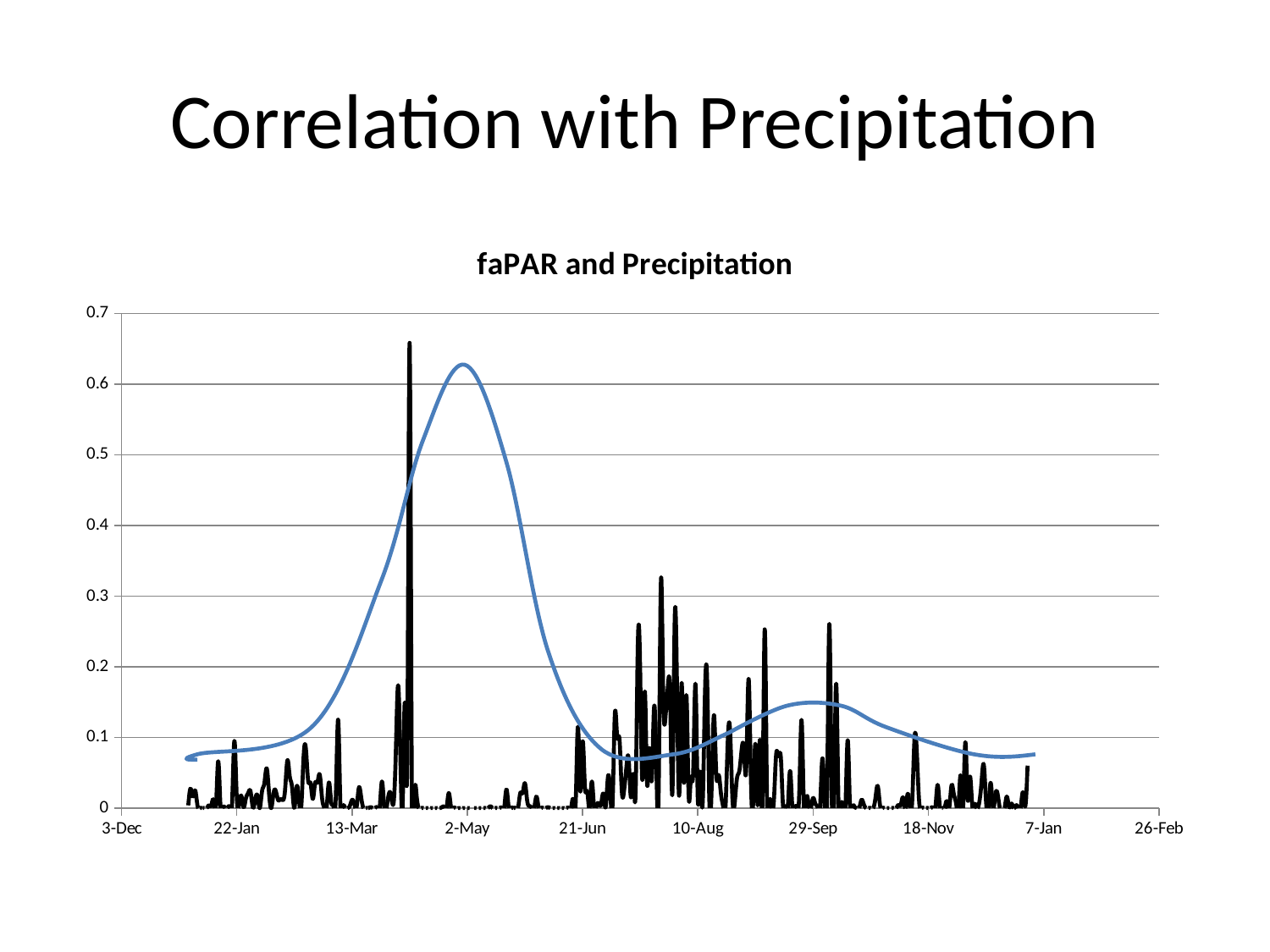
Does the blue line rise or fall between 13-Mar and 2-May? rise Is the value of the blue line at 22-Jan greater or less than 0.1? less Is the value of the blue line at 29-Sep greater or less than 0.1? greater Is the peak of the smooth blue line greater or less than 0.5? greater What is the highest value shown on the y axis? 0.7 How many date labels are shown along the x axis? 10 Does the blue line rise or fall between 2-May and 21-Jun? fall What kind of chart is shown on the slide? line chart What is the title of the chart? faPAR and Precipitation Around which x-axis date does the blue line reach its highest point? 2-May How many lines are plotted on the chart? 2